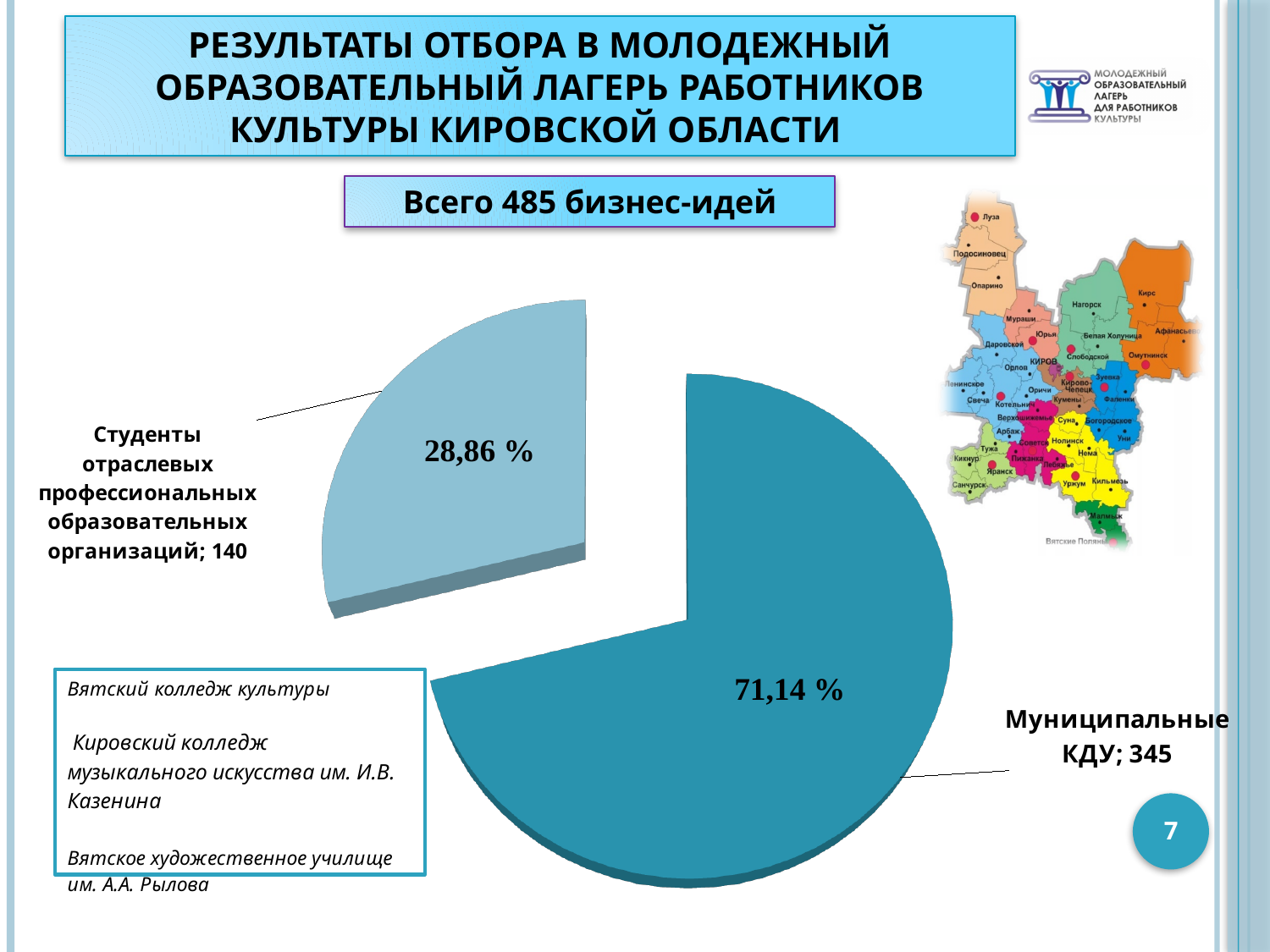
What is the difference between the values for Муниципальные КДУ and Студенты отраслевых профессиональных образовательных организаций? 205 What value is shown for Муниципальные КДУ? 345 What is the total of the two pie slice values? 485 What percentage share of the pie do Студенты отраслевых профессиональных образовательных организаций have? 28,86 % Which is larger: the value for Муниципальные КДУ or for Студенты отраслевых профессиональных образовательных организаций? Муниципальные КДУ Which category has the smallest slice of the pie? Студенты отраслевых профессиональных образовательных организаций What value is shown for Студенты отраслевых профессиональных образовательных организаций? 140 How many slices does the pie chart have? 2 What total number of business ideas is stated above the pie chart? 485 Which category has the largest slice of the pie? Муниципальные КДУ What percentage share of the pie does Муниципальные КДУ have? 71,14 % What kind of chart is shown on the slide? pie chart